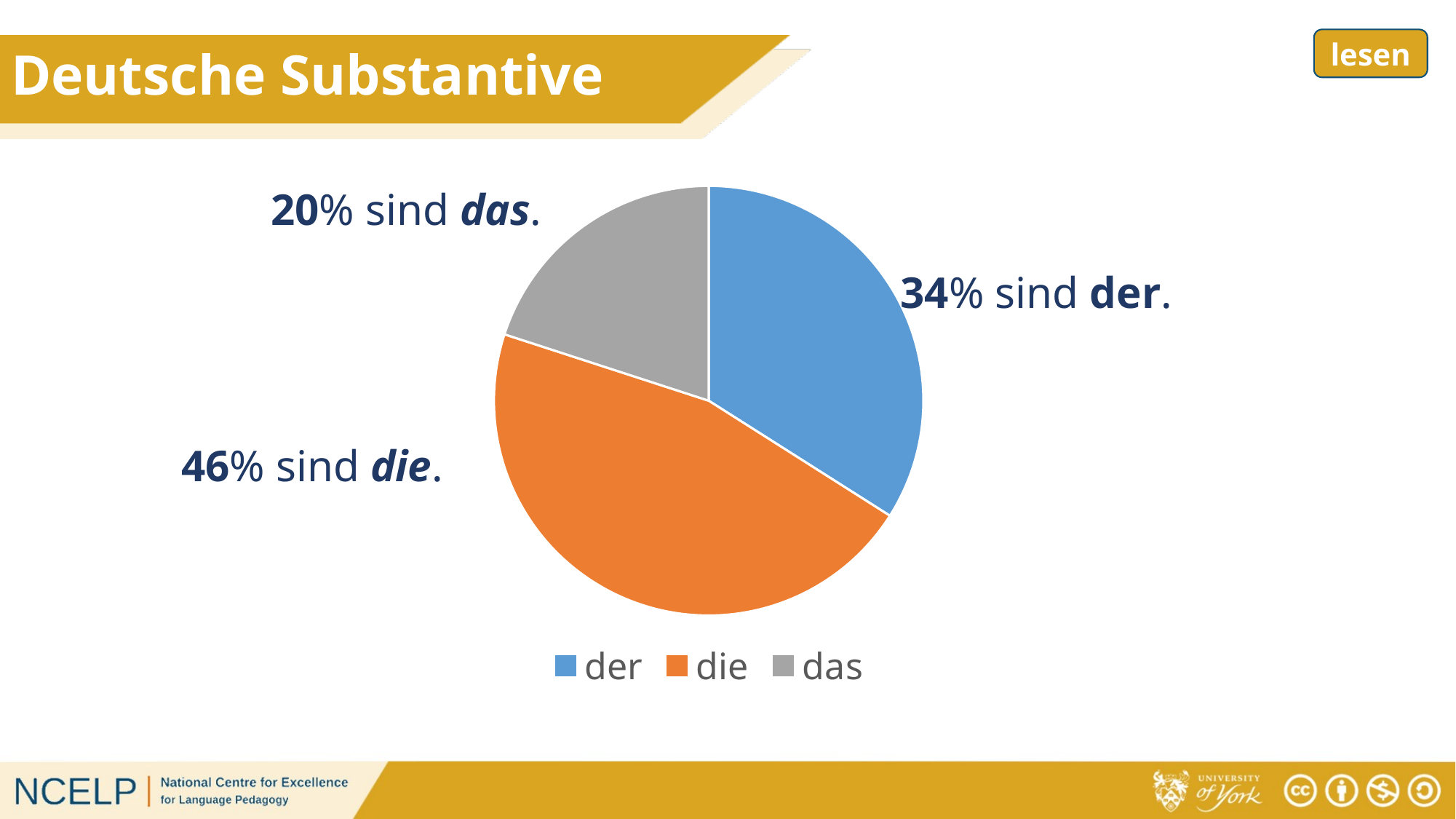
Which article has the largest share of the pie? die What colour is the slice for 'die'? orange What is the difference in percentage points between the 'die' share and the 'der' share? 12 What percentage of German nouns are 'der' according to the slide? 34% What percentage of German nouns are 'das' according to the slide? 20% What percentage of German nouns are 'die' according to the slide? 46% What is the difference in percentage points between the 'der' share and the 'das' share? 14 Which is larger, the share for 'der' or the share for 'das'? der What kind of chart is shown on the slide? pie chart Which article has the smallest share of the pie? das How many entries does the legend list? 3 How many slices does the pie chart have? 3